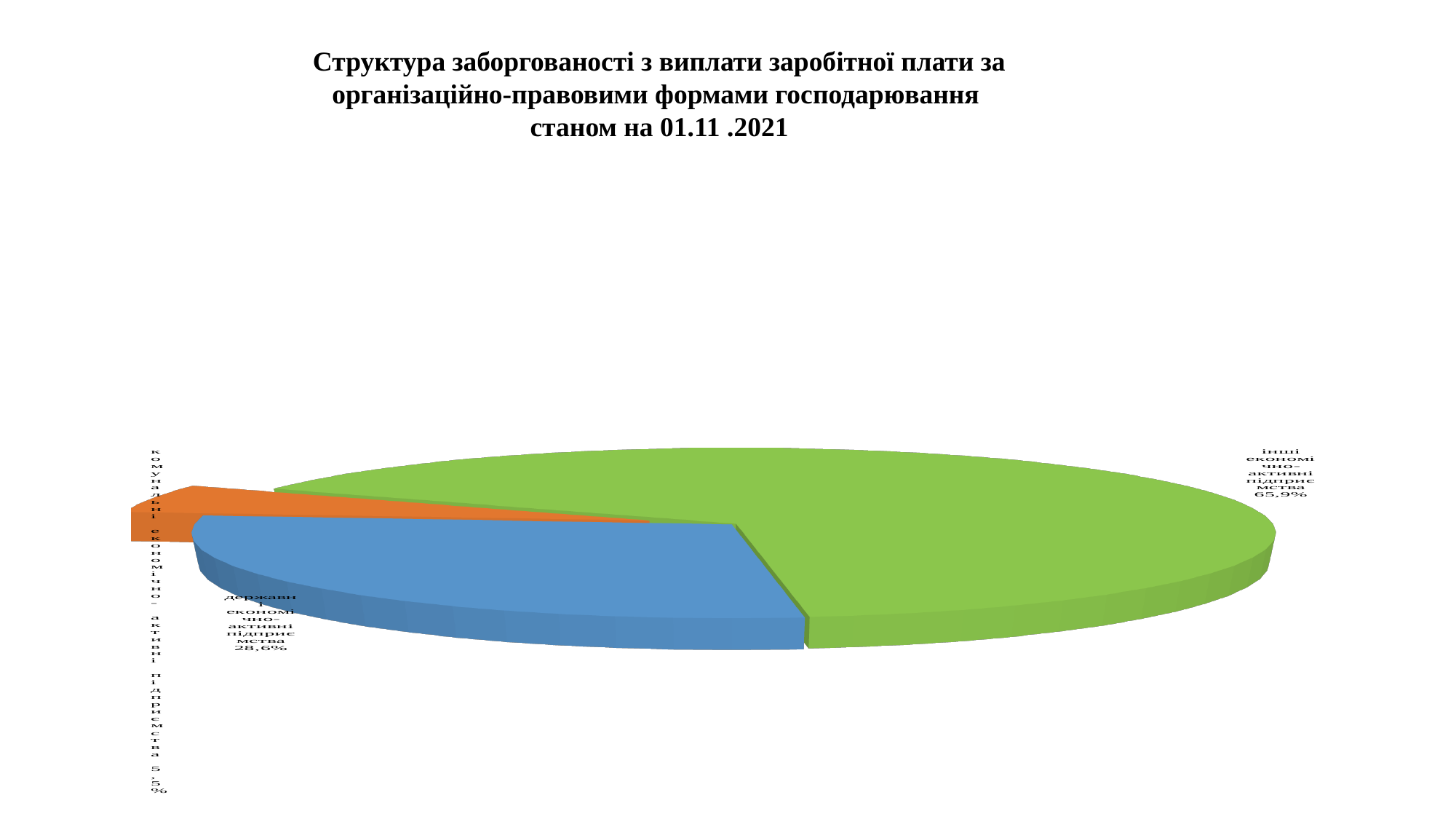
What type of chart is shown on the slide? pie chart What colour is the slice for державні економічно-активні підприємства? blue How many slices does the pie chart have? 3 What is the difference in percentage points between the shares of інші and державні економічно-активні підприємства? 37,3 As of what date does the chart show the structure of wage arrears? 01.11.2021 What share of the wage arrears is attributed to комунальні економічно-активні підприємства? 5,5% What share of the wage arrears is attributed to державні економічно-активні підприємства? 28,6% What share of the wage arrears is attributed to інші економічно-активні підприємства? 65,9% Which category has the smallest slice of the pie? комунальні економічно-активні підприємства What is the difference in percentage points between the shares of державні and комунальні економічно-активні підприємства? 23,1 Which category has the largest slice of the pie? інші економічно-активні підприємства Which is larger: the share of державні економічно-активні підприємства or the share of комунальні економічно-активні підприємства? державні економічно-активні підприємства